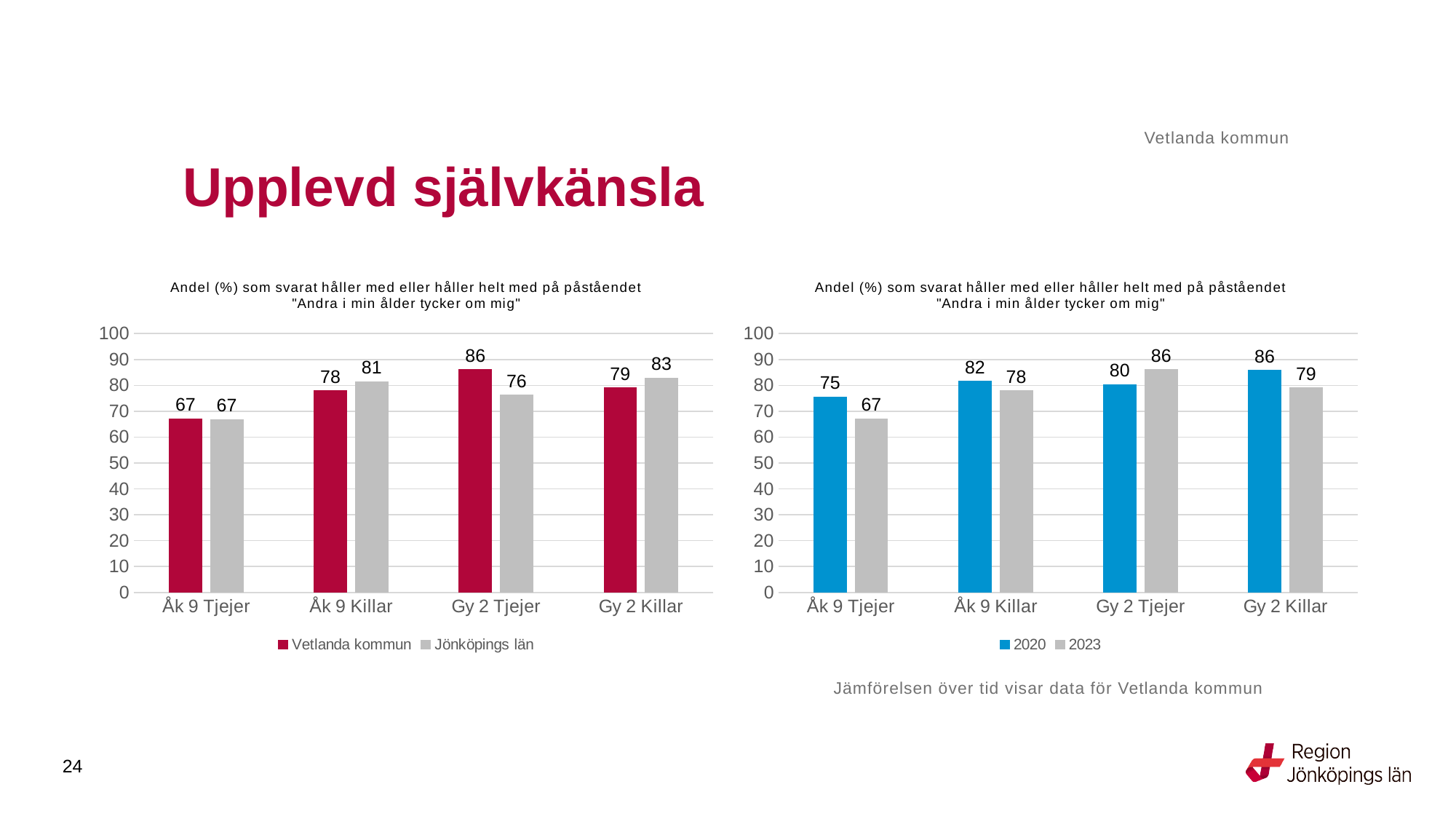
In the right chart, what is the 2023 value for Gy 2 Killar? 79 How many series does the legend of the right chart list? 2 How many categories are shown on the x axis of the left chart? 4 In the left chart, what is the difference between Vetlanda kommun and Jönköpings län for Gy 2 Tjejer? 10 In the left chart, what is the value for Jönköpings län for Åk 9 Killar? 81 In the right chart, what is the difference between the 2020 and 2023 values for Åk 9 Tjejer? 8 In the left chart, what is the value for Vetlanda kommun for Gy 2 Tjejer? 86 In the right chart, which is larger for Gy 2 Tjejer: the 2020 value or the 2023 value? 2023 In the left chart, which category has the highest value for Vetlanda kommun? Gy 2 Tjejer In the right chart, which category has the lowest value for 2023? Åk 9 Tjejer In the right chart, what is the 2020 value for Åk 9 Tjejer? 75 What type of chart is the left chart? Bar chart